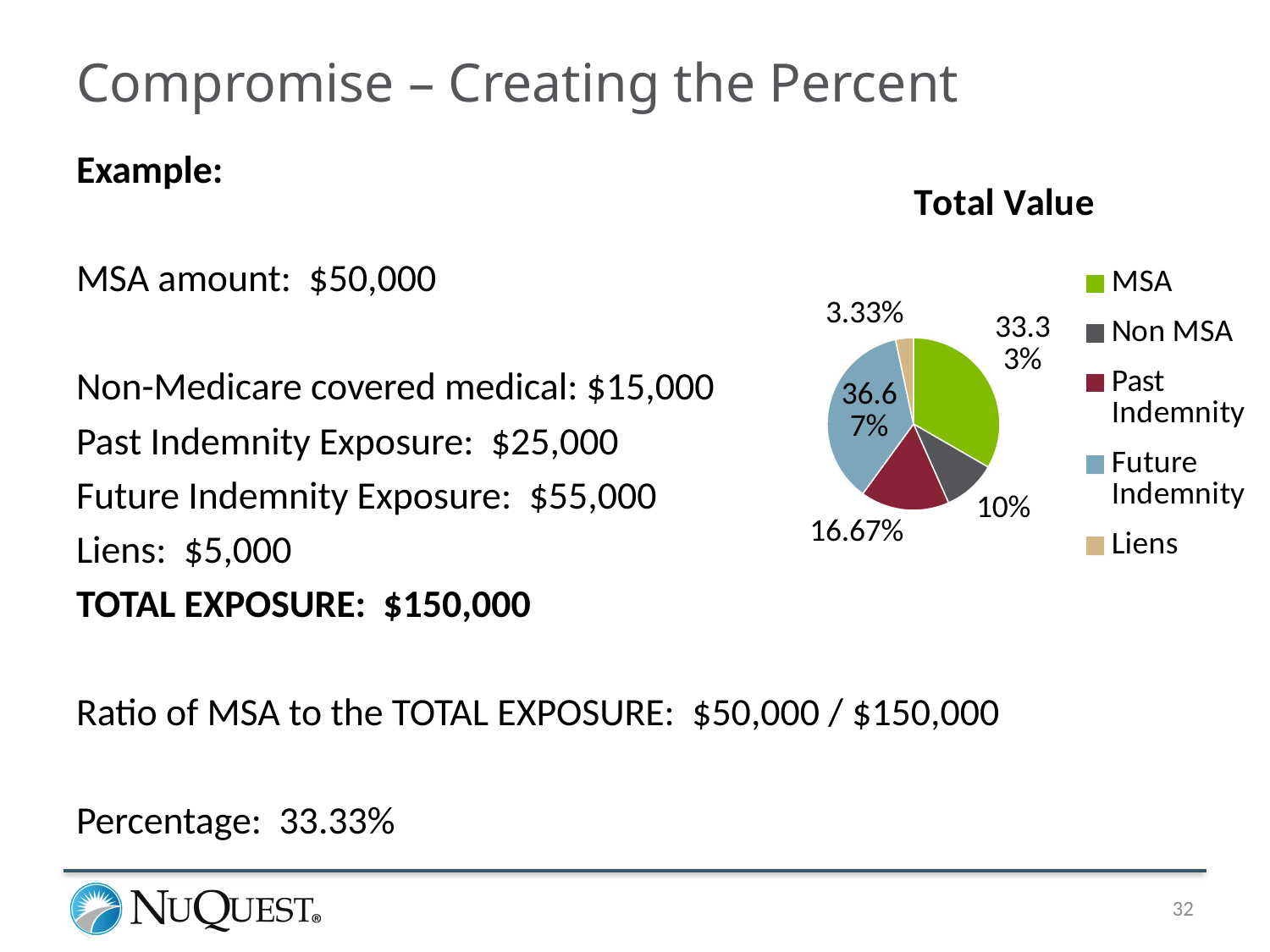
Which slice is larger, Past Indemnity or Non MSA? Past Indemnity What is the title of the chart? Total Value What kind of chart is shown on the slide? pie chart Which category has the largest slice in the pie chart? Future Indemnity What percentage does the Past Indemnity slice show in the pie chart? 16.67% What is the difference in percentage points between the Past Indemnity slice and the Non MSA slice? 6.67 What share of the pie does the MSA slice represent? 33.33% Which category has the smallest slice in the pie chart? Liens What share of the pie does the Future Indemnity slice represent? 36.67% What percentage does the Liens slice show in the pie chart? 3.33% How many categories does the legend of the pie chart list? 5 What percentage does the Non MSA slice show in the pie chart? 10%